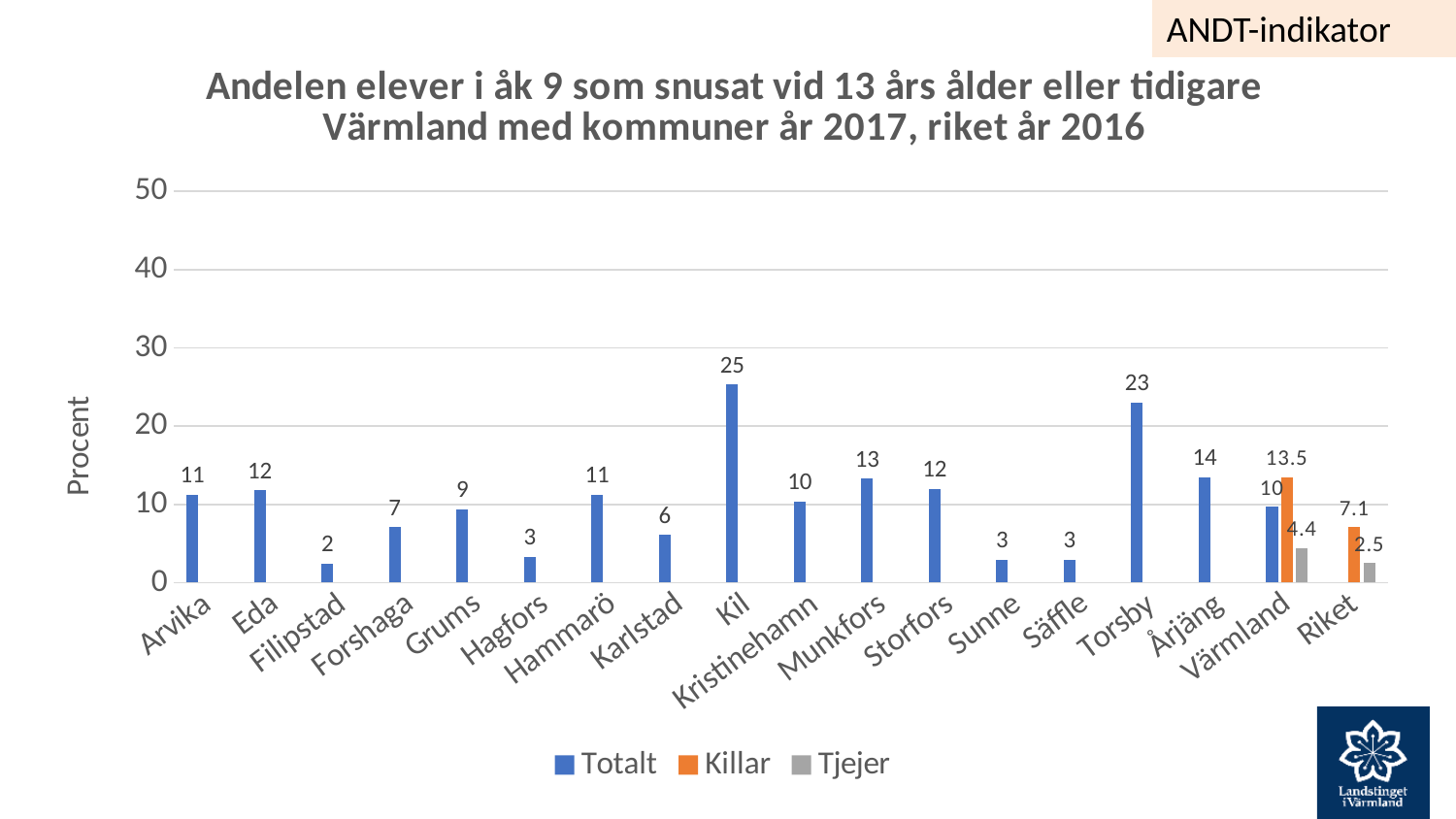
What is the Killar value for Värmland? 13.5 How many series does the legend list? 3 What is the difference between the Totalt values for Kil and Torsby? 2 What is the label on the y axis? Procent What is the Tjejer value for Riket? 2.5 Which category has the highest Totalt value? Kil Which category has the lowest Totalt value? Filipstad How many categories are shown on the x axis? 18 What kind of chart is shown on the slide? Bar chart Which has a higher Totalt value, Eda or Arvika? Eda What is the difference between the Killar and Tjejer values for Värmland? 9.1 What is the Totalt value for Kil? 25